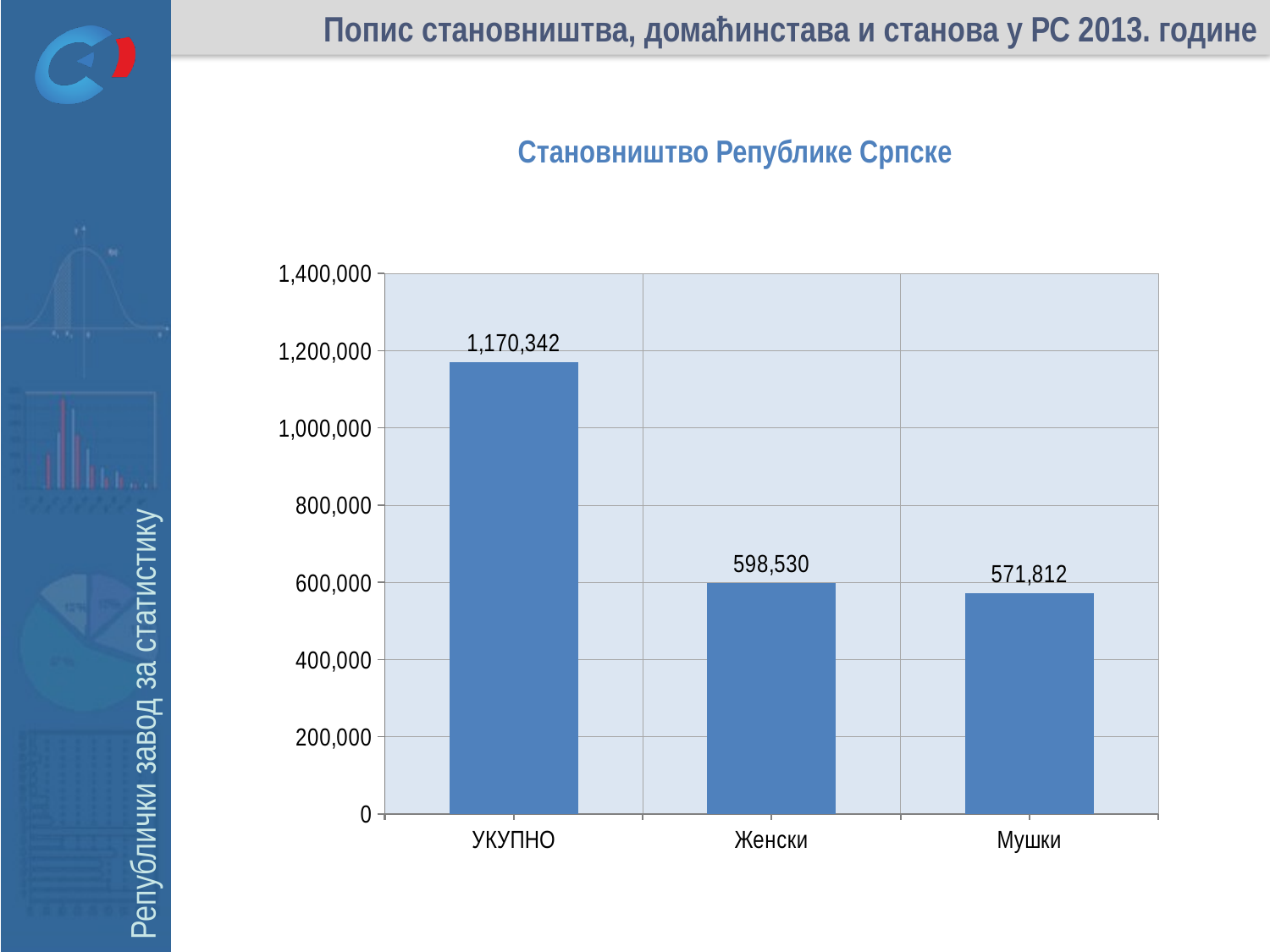
Which is larger, the value for Женски or the value for Мушки? Женски What is the difference between the values for Женски and Мушки? 26,718 What is the value for Женски? 598,530 What is the difference between the values for УКУПНО and Женски? 571,812 What is the title of the chart? Становништво Републике Српске How many categories are shown on the x axis? 3 What kind of chart is shown on the slide? bar chart Is the value for Мушки greater or less than 800,000? less Which category has the lowest value? Мушки What is the value for УКУПНО? 1,170,342 What is the value for Мушки? 571,812 Which category has the highest value? УКУПНО